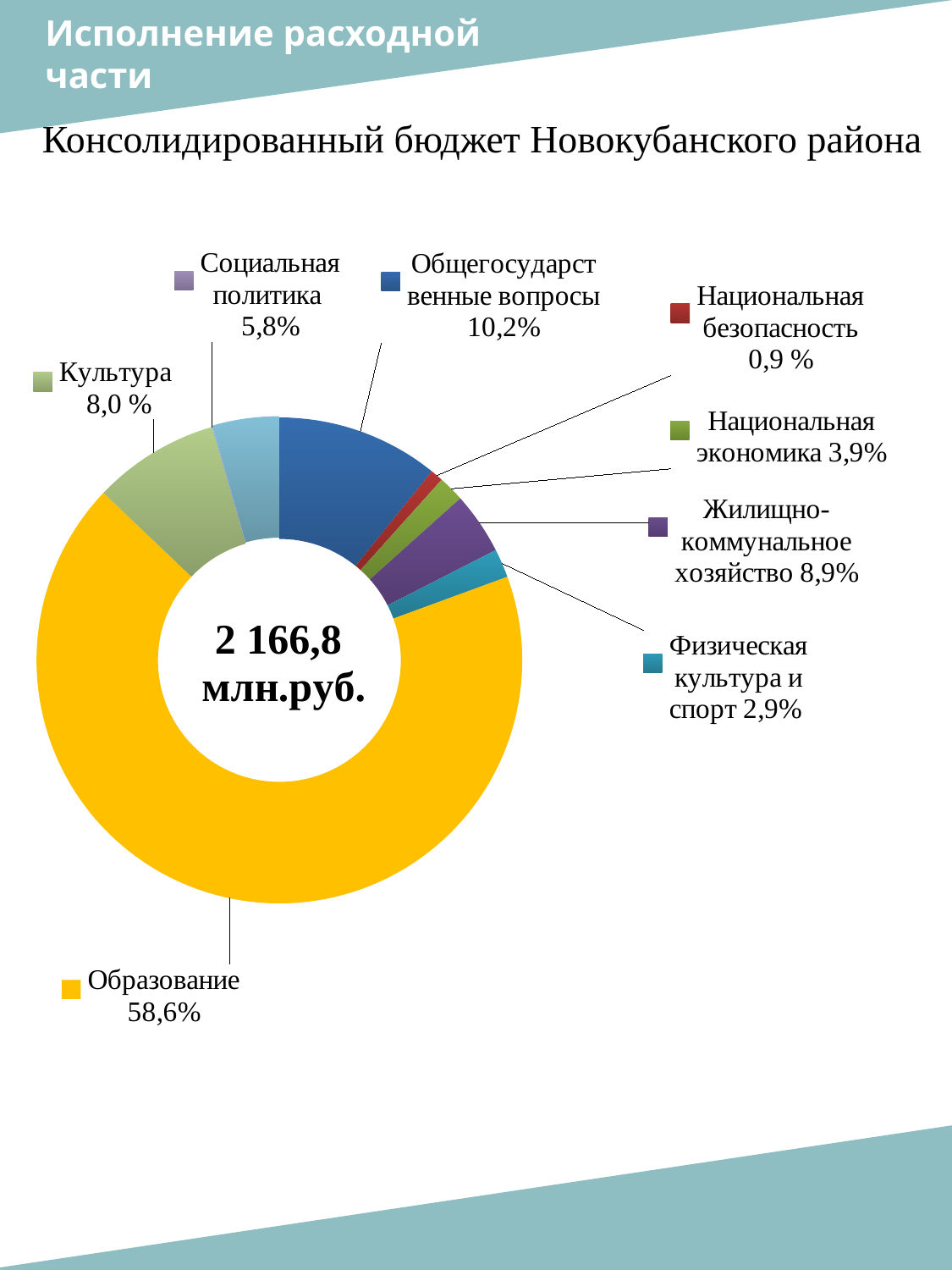
What is the value shown for Жилищно-коммунальное хозяйство? 8,9% Which category has the largest share of the chart? Образование Which is larger, the share for Национальная экономика or the share for Физическая культура и спорт? Национальная экономика What is the difference between the shares of Культура and Социальная политика? 2,2% What is the value shown for Физическая культура и спорт? 2,9% How many categories are shown in the chart? 8 What is the title of the chart? Консолидированный бюджет Новокубанского района What kind of chart is shown on the slide? Doughnut chart What share of the chart does Образование account for? 58,6% Which category has the smallest share of the chart? Национальная безопасность What is the value shown for Общегосударственные вопросы? 10,2% What total amount is printed in the centre of the chart? 2 166,8 млн.руб.